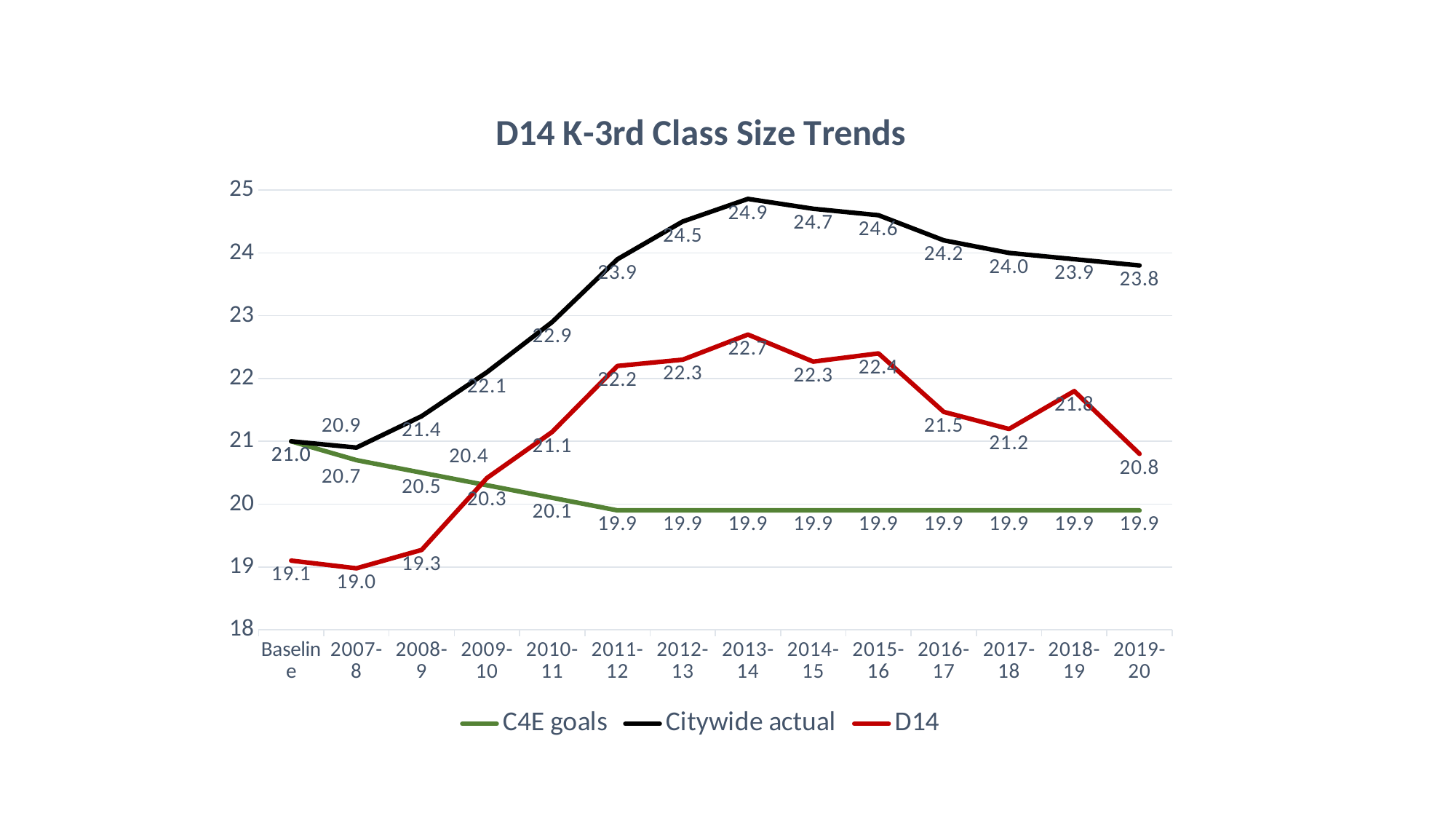
In which year is the D14 value lowest? 2007-8 What is the title of the chart? D14 K-3rd Class Size Trends How many series does the legend list? 3 Do the C4E goals values rise or fall from Baseline to 2011-12? Fall What kind of chart is shown on the slide? Line chart What is the C4E goals value for 2010-11? 20.1 What is the D14 value for 2019-20? 20.8 In which year is the Citywide actual value highest? 2013-14 What is the difference between the Citywide actual and D14 values in 2019-20? 3.0 What is the Citywide actual value for 2013-14? 24.9 Which is larger for D14: the value in 2013-14 or the value in 2015-16? 2013-14 How many categories are shown along the x axis? 14